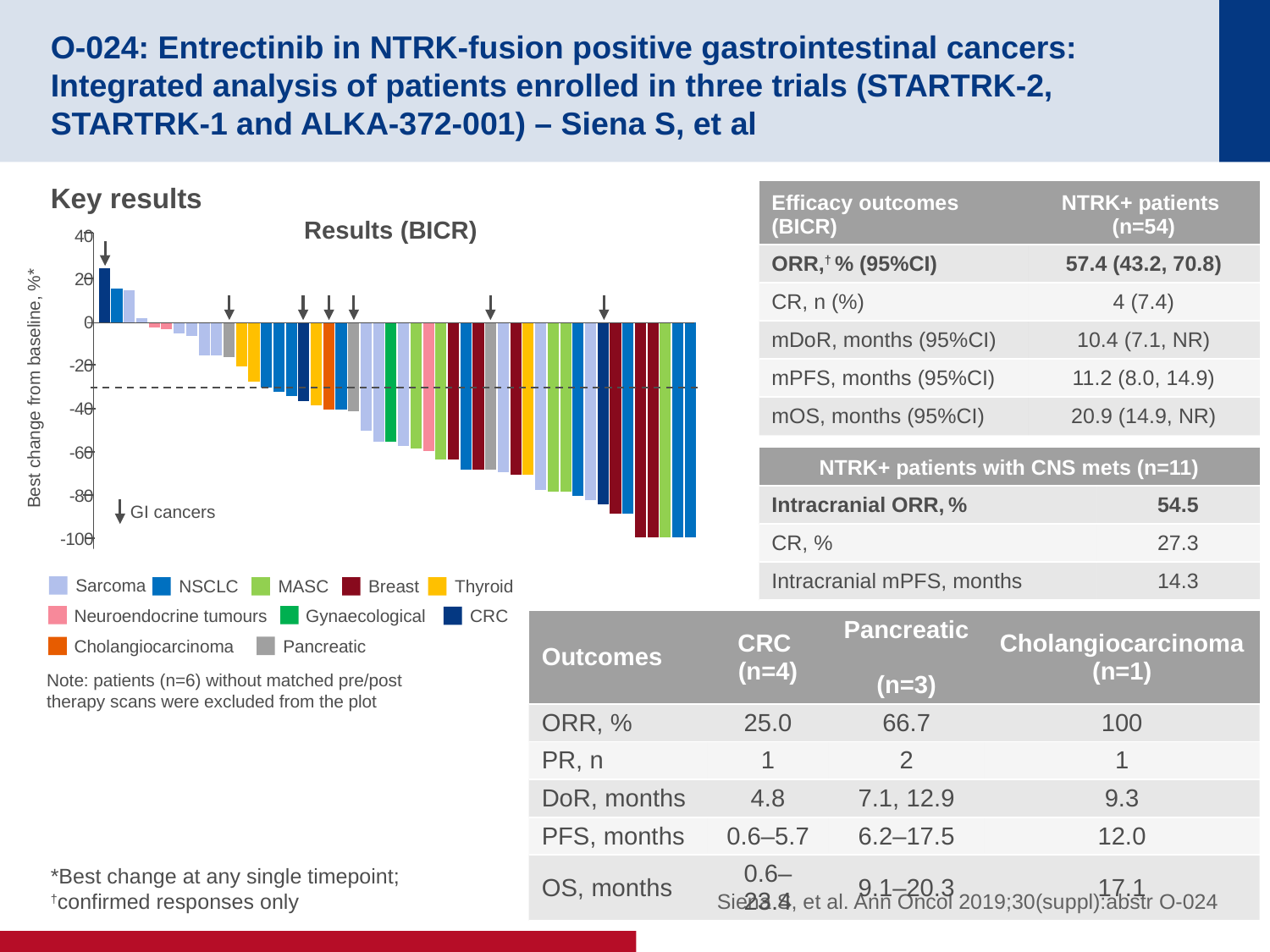
What is the lowest value shown on the vertical axis of the "Results (BICR)" chart? -100 In the "Results (BICR)" chart, which bar is higher: the leftmost bar or the rightmost bar? the leftmost bar In the "Results (BICR)" chart, is the value of the leftmost bar greater or less than 20? greater What kind of chart is shown under the title "Results (BICR)"? bar chart In the "Results (BICR)" chart, is the value of the leftmost bar greater or less than 40? less In the "Results (BICR)" chart, do the bar values rise or fall from left to right? fall What is the highest value shown on the vertical axis of the "Results (BICR)" chart? 40 In the "Results (BICR)" chart, is the value of the rightmost bar greater or less than -80? less What is the title of the chart on the slide? Results (BICR) What is the label of the vertical axis of the "Results (BICR)" chart? Best change from baseline, %* How many tumour types does the legend of the "Results (BICR)" chart list? 10